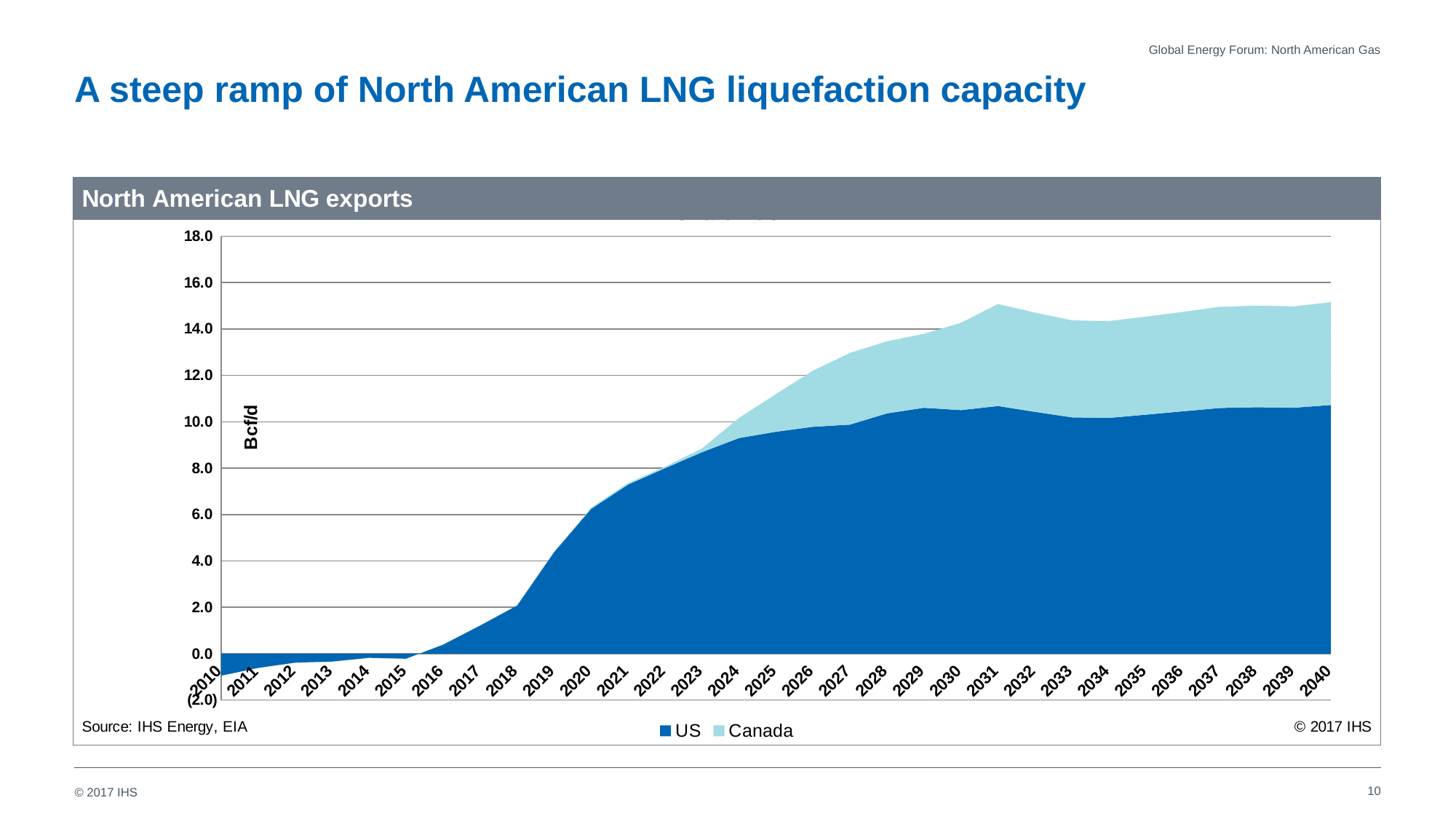
How many series does the legend list? 2 Is the value for US in 2016 greater or less than 2.0? less Which two series are listed in the chart legend? US and Canada Is the total stacked value in 2025 greater or less than 10.0? greater What is the title of the chart? North American LNG exports What kind of chart is shown on the slide? area chart How many years are plotted along the x axis? 31 Do total North American LNG exports rise or fall between 2016 and 2030? rise In 2040, which series is larger, US or Canada? US Is the value for US in 2040 greater or less than 10.0? greater